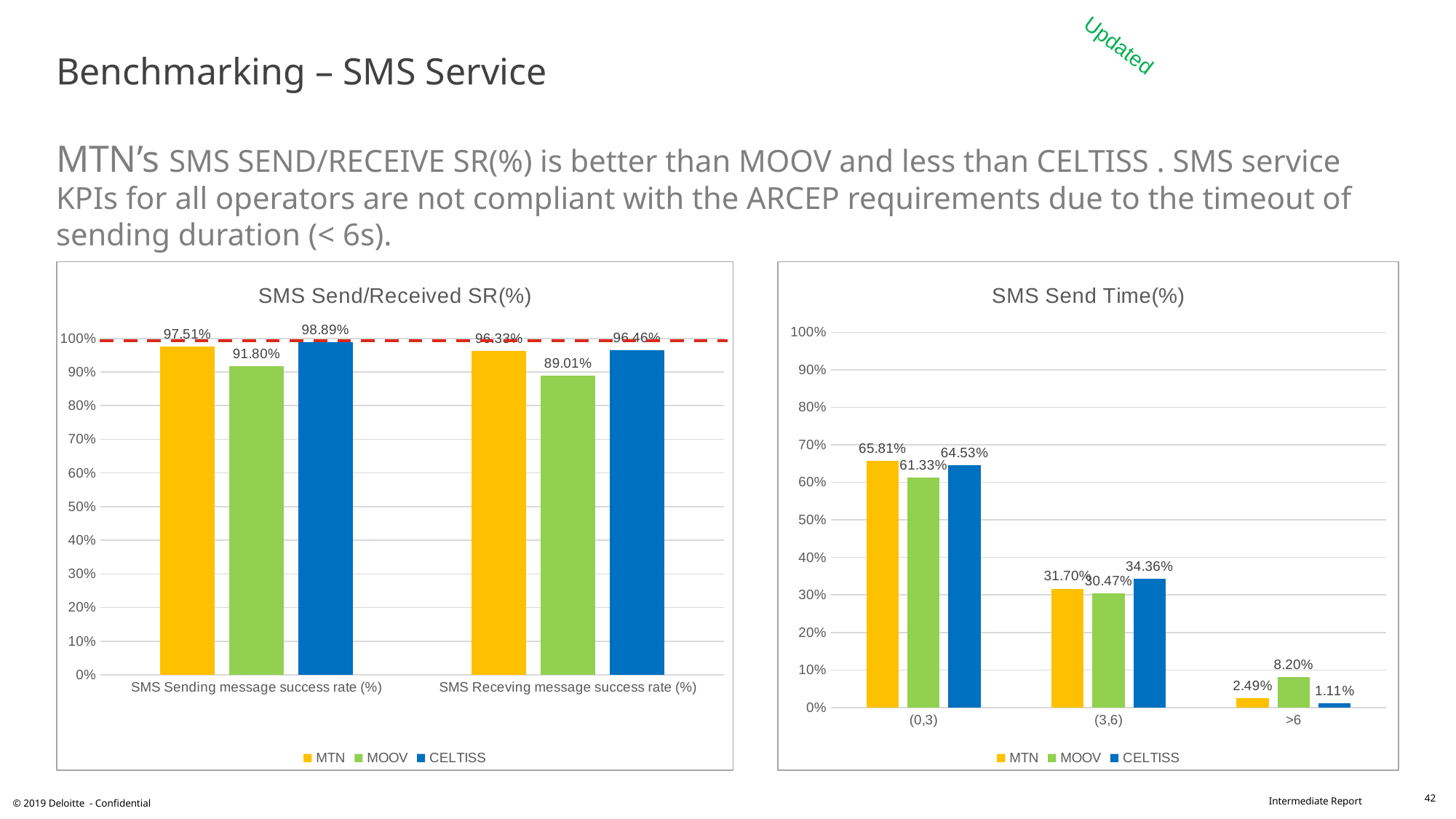
In the SMS Send/Received SR(%) chart, what is the difference between CELTISS and MOOV for SMS Sending message success rate (%)? 7.09% What kind of chart is the SMS Send Time(%) chart? Bar chart In the SMS Send Time(%) chart, what is the value for CELTISS in the (0,3) category? 64.53% In the SMS Send Time(%) chart, what is the difference between MTN and CELTISS in the >6 category? 1.38% In the SMS Send/Received SR(%) chart, what is the value for MOOV for SMS Sending message success rate (%)? 91.80% In the SMS Send Time(%) chart, what is the value for MOOV in the >6 category? 8.20% In the SMS Send/Received SR(%) chart, which operator has the lowest SMS Receving message success rate (%)? MOOV In the SMS Send Time(%) chart, which operator has the highest value in the (3,6) category? CELTISS In the SMS Send/Received SR(%) chart, which operator has the highest SMS Sending message success rate (%)? CELTISS In the SMS Send/Received SR(%) chart, what is the value for MTN for SMS Sending message success rate (%)? 97.51% How many categories are shown on the x axis of the SMS Send Time(%) chart? 3 How many series does the legend of the SMS Send/Received SR(%) chart list? 3